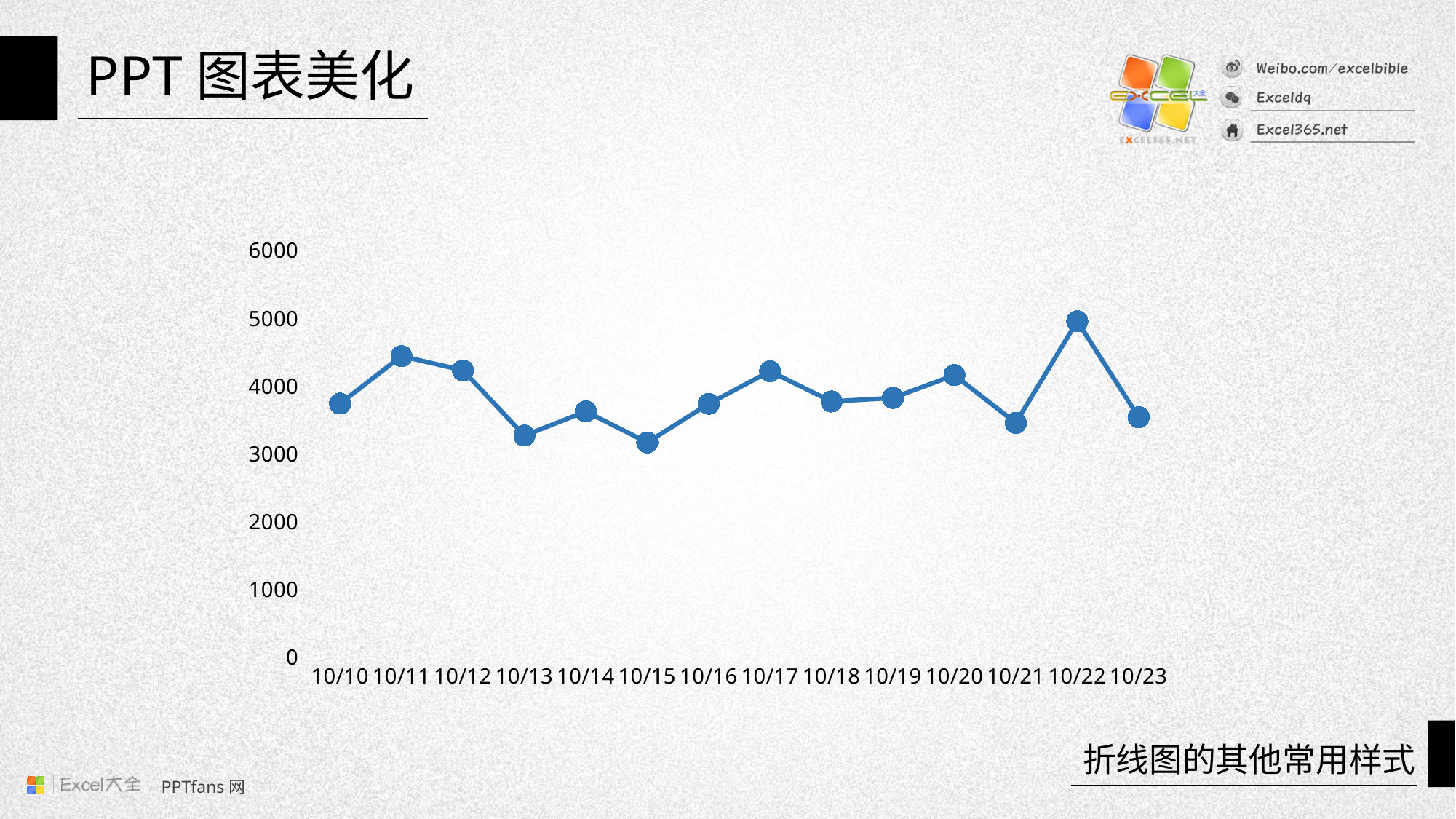
Is the value for 10/13 greater or less than 4000? less Which has the larger value, 10/22 or 10/21? 10/22 What is the highest value shown on the vertical axis? 6000 Is the value for 10/22 greater or less than 4000? greater How many data points are plotted on the line chart? 14 Is the value for 10/11 greater or less than 4000? greater Does the value rise or fall from 10/22 to 10/23? fall What kind of chart is shown on the slide? line chart Which date has the highest value on the line chart? 10/22 Which has the larger value, 10/11 or 10/13? 10/11